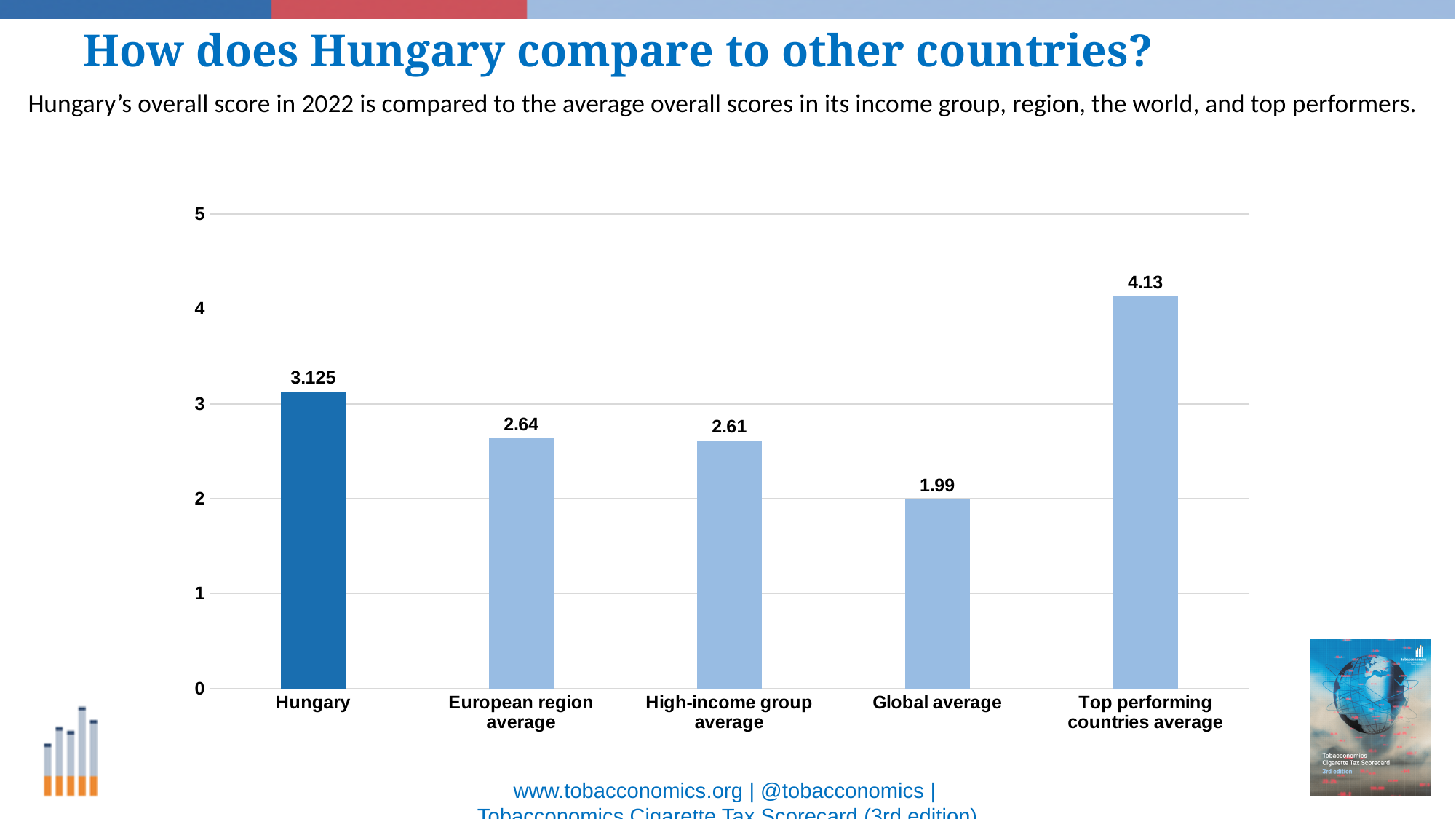
How many categories are shown on the x axis? 5 Which category has the lowest value? Global average Is the value for the European region average greater or less than 3? less Which category has the highest value? Top performing countries average What kind of chart is shown on the slide? bar chart What is the difference between Hungary and the Global average? 1.135 What is the value shown for Hungary? 3.125 Which is larger, the value for Hungary or the European region average? Hungary What is the value shown for the Top performing countries average? 4.13 What is the difference between the Top performing countries average and Hungary? 1.005 What is the value shown for the High-income group average? 2.61 What is the value shown for the Global average? 1.99